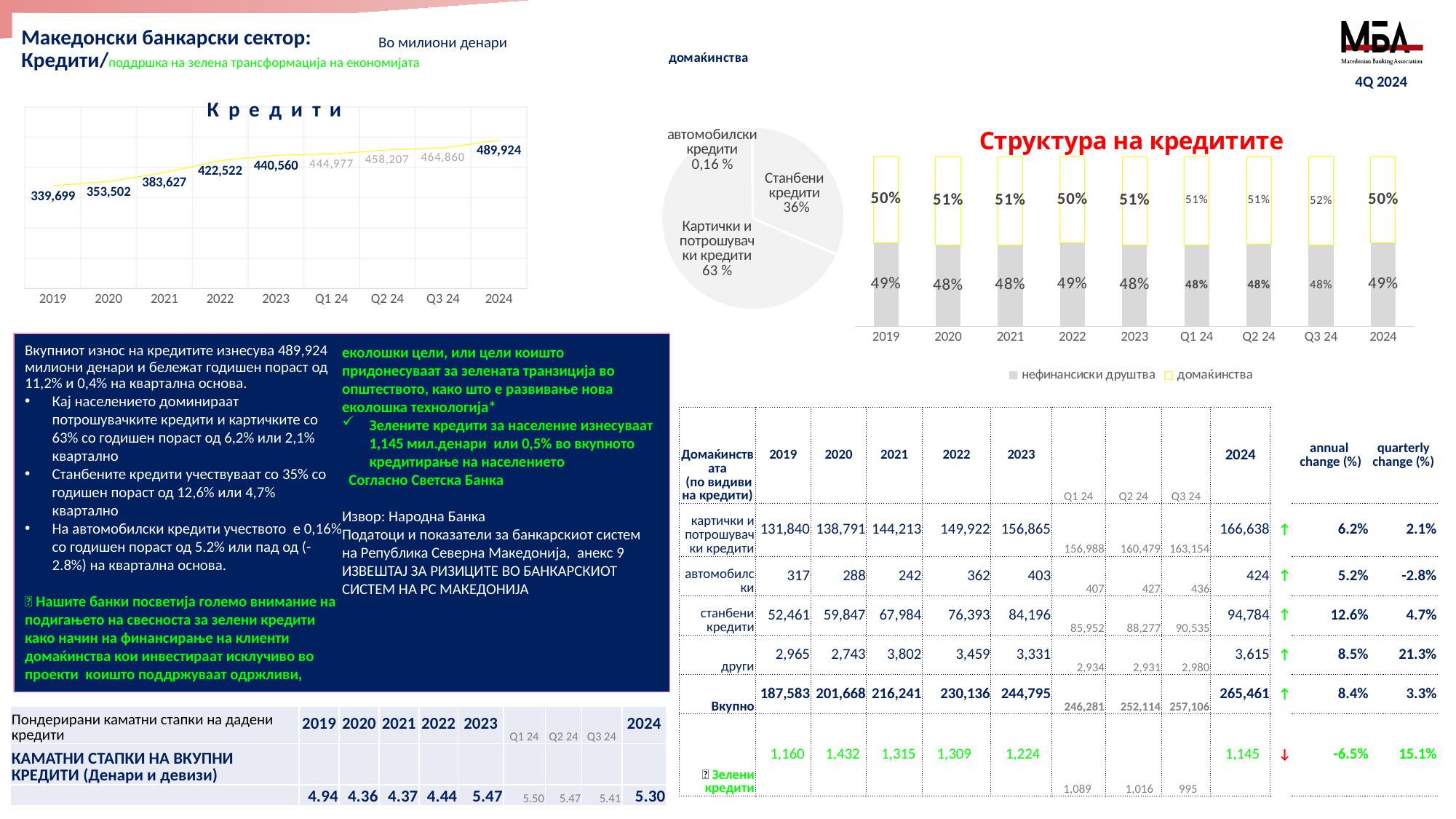
How many data points are plotted in the line chart titled 'Кредити'? 9 In the pie chart titled 'домаќинства', what share do 'Картички и потрошувачки кредити' have? 63 % In the line chart titled 'Кредити', what is the difference between the values for 2024 and 2023? 49,364 How many series does the legend of the stacked bar chart titled 'Структура на кредитите' list? 2 In the line chart titled 'Кредити', which point on the x axis has the highest value? 2024 In the pie chart titled 'домаќинства', what share do 'Станбени кредити' have? 36% In the stacked bar chart titled 'Структура на кредитите', what is the value for 'домаќинства' in Q3 24? 52% In the line chart titled 'Кредити', what is the value for 2019? 339,699 In the line chart titled 'Кредити', do the values rise or fall from 2019 to 2024? rise In the line chart titled 'Кредити', what is the value for Q2 24? 458,207 In the line chart titled 'Кредити', what is the value for 2024? 489,924 In the pie chart titled 'домаќинства', which slice is the smallest? автомобилски кредити